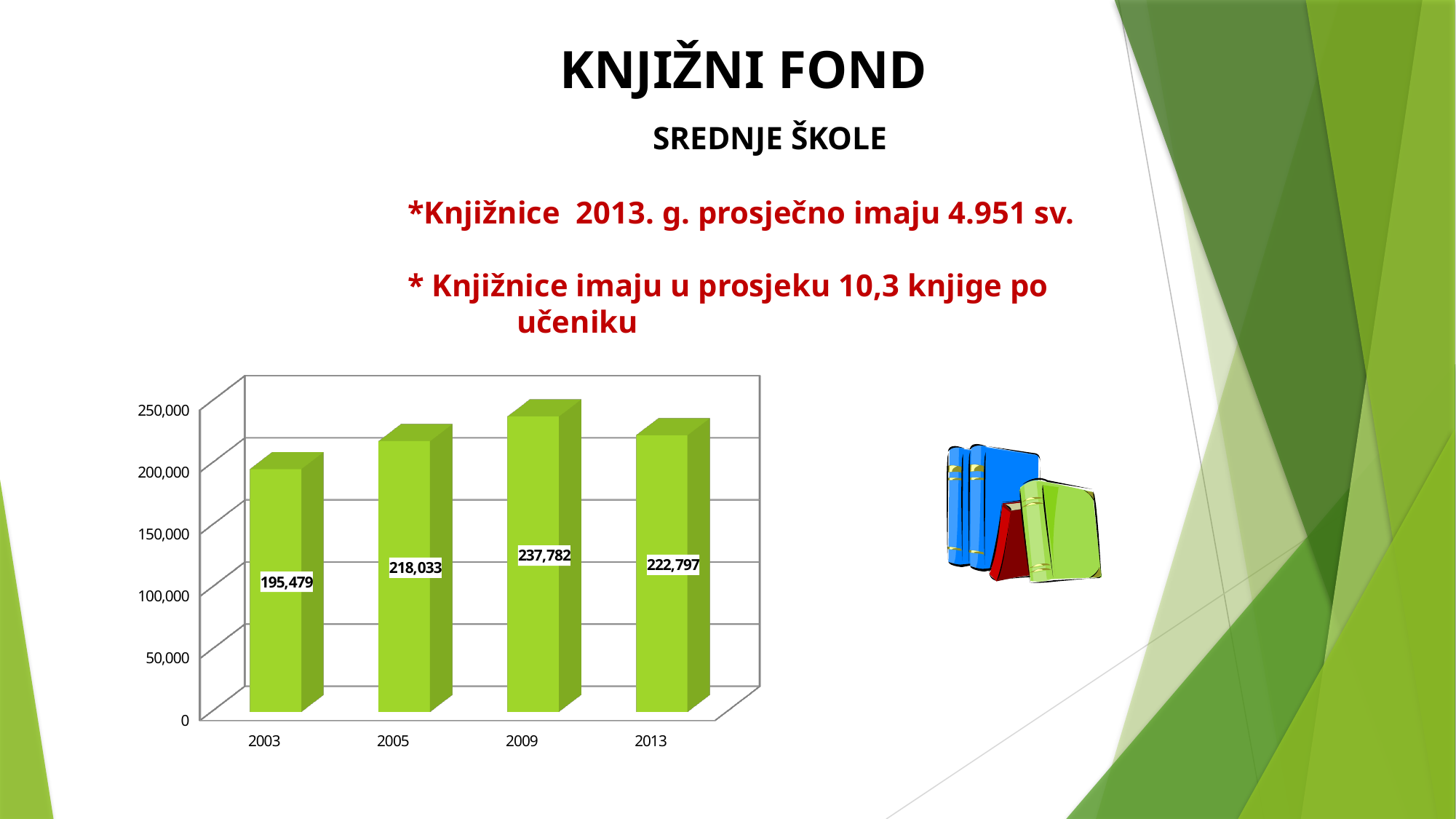
Is the value for 2003 greater or less than 200,000? less What is the value for 2003? 195,479 What is the difference between the values for 2009 and 2013? 14,985 What is the value for 2013? 222,797 What is the value for 2009? 237,782 What is the difference between the values for 2005 and 2003? 22,554 How many years are shown on the x axis? 4 Which year has the highest value? 2009 Which is larger, the value for 2005 or the value for 2013? 2013 What is the value for 2005? 218,033 What kind of chart is shown on the slide? bar chart Which year has the lowest value? 2003